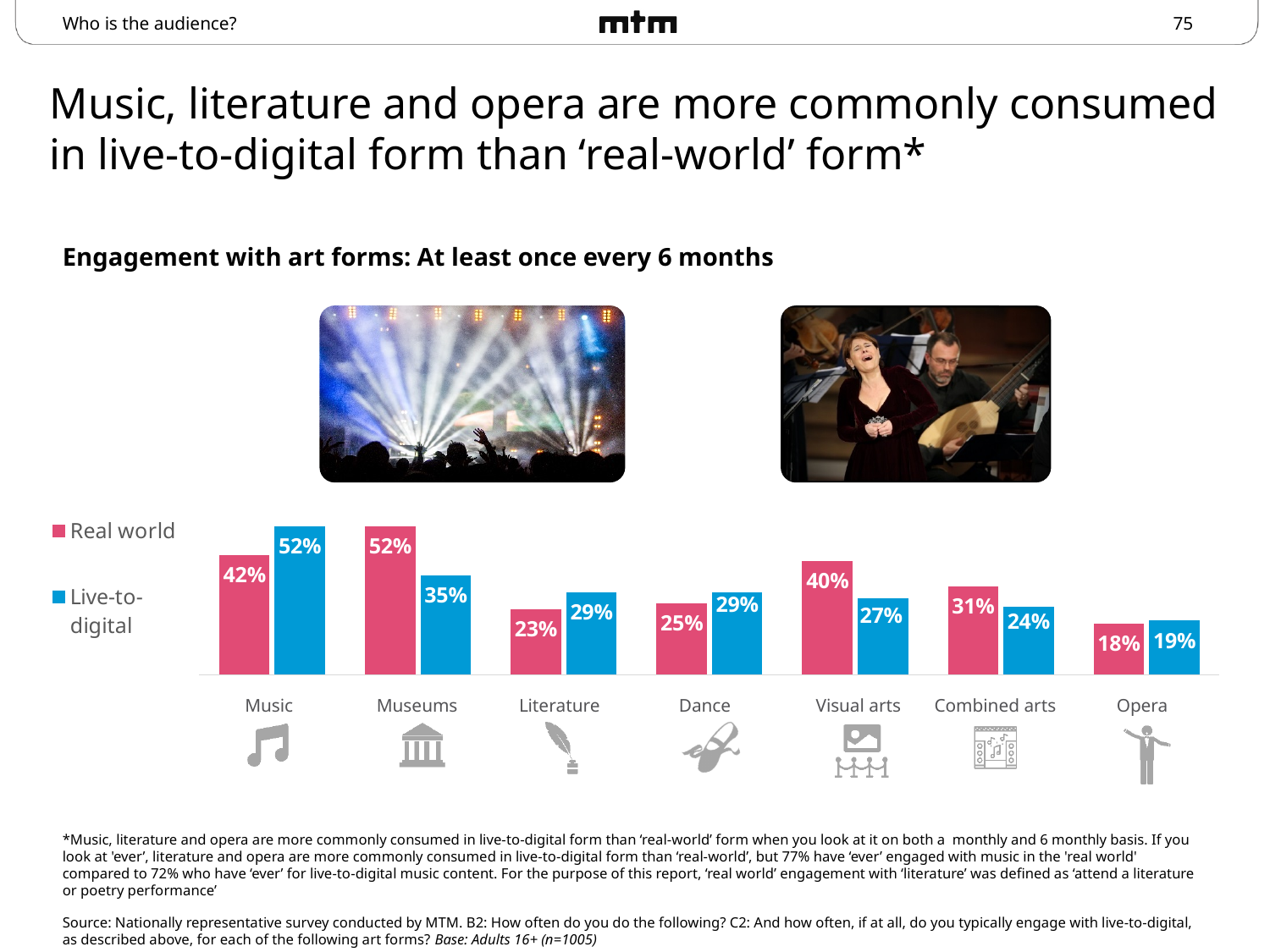
What is the Live-to-digital value for Opera? 19% What is the title of the chart? Engagement with art forms: At least once every 6 months Which is larger for Visual arts: the Real world value or the Live-to-digital value? Real world What is the Live-to-digital value for Museums? 35% Which is larger for Literature: the Real world value or the Live-to-digital value? Live-to-digital Which category has the highest Live-to-digital value? Music How many series does the legend list? 2 How many art form categories are shown on the chart? 7 Which category has the lowest Real world value? Opera What is the difference between the Real world and Live-to-digital values for Museums? 17% What kind of chart is shown on the slide? Bar chart What is the Real world value for Music? 42%